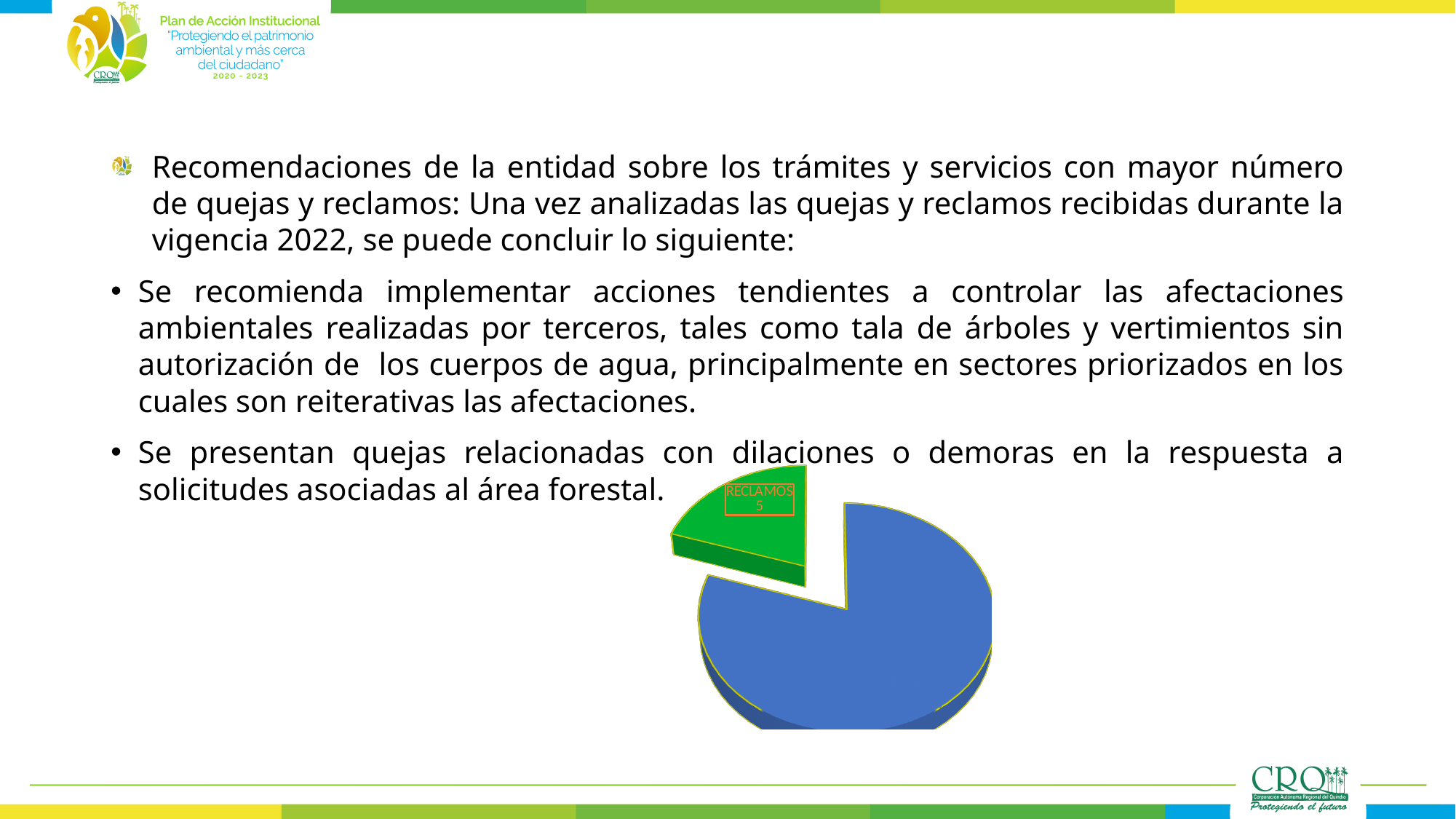
What colour is the RECLAMOS slice in the pie chart? green What value is printed on the RECLAMOS slice of the pie chart? 5 Is the RECLAMOS slice the largest or the smallest slice of the pie chart? smallest Which slice of the pie chart is pulled out (exploded) from the rest? RECLAMOS What kind of chart is shown on the slide? pie chart How many slices does the pie chart have? 2 Which slice of the pie chart is larger, the green RECLAMOS slice or the blue slice? the blue slice